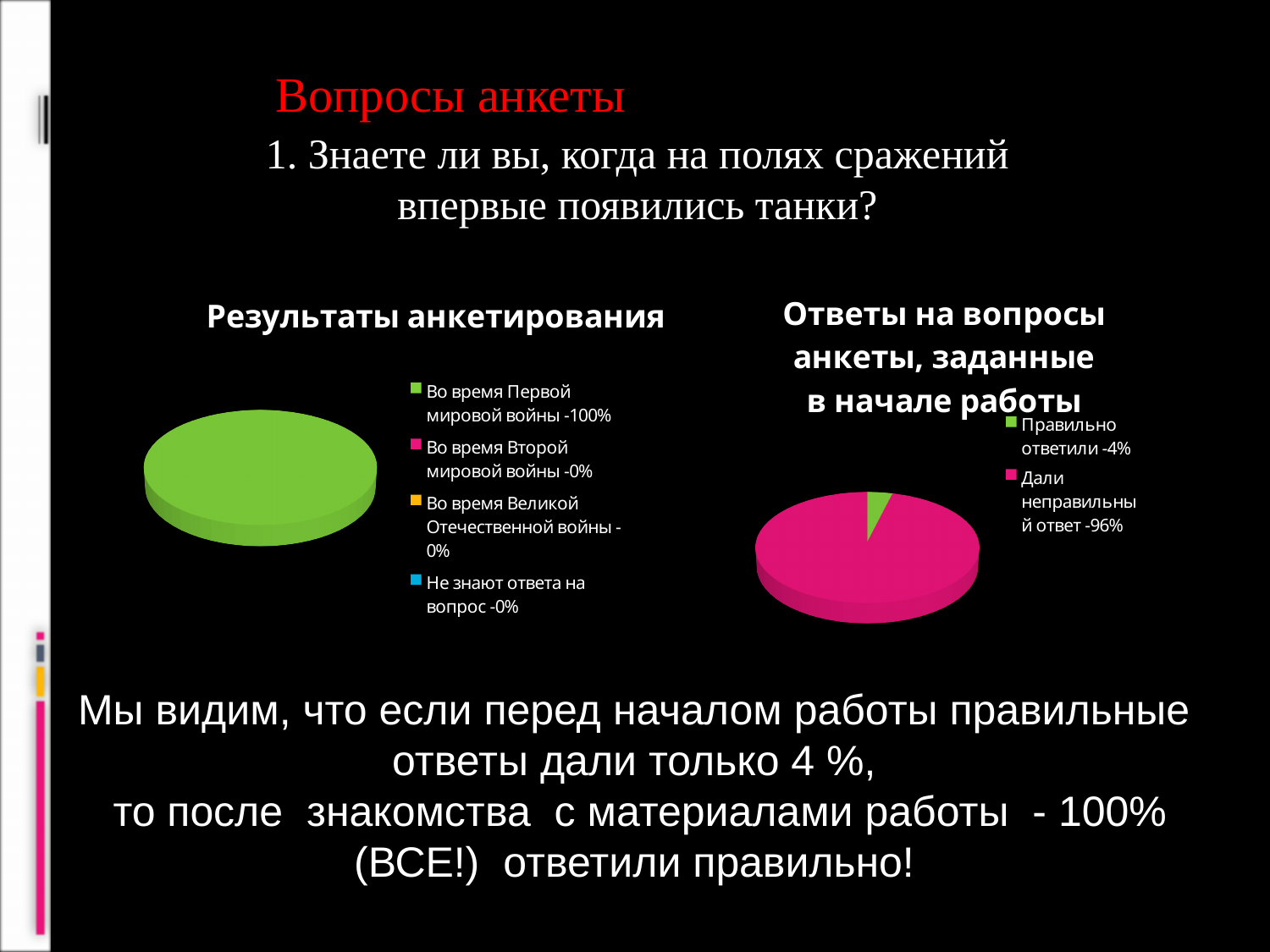
In the right chart "Ответы на вопросы анкеты, заданные в начале работы", which category has the smallest slice? Правильно ответили What type of chart is the right chart titled "Ответы на вопросы анкеты, заданные в начале работы"? pie chart How many entries does the legend of the left chart "Результаты анкетирования" list? 4 What type of chart is the left chart titled "Результаты анкетирования"? pie chart In the right chart "Ответы на вопросы анкеты, заданные в начале работы", what share is given for "Дали неправильный ответ"? 96% In the right chart "Ответы на вопросы анкеты, заданные в начале работы", what share is given for "Правильно ответили"? 4% In the left chart "Результаты анкетирования", what share is given for "Во время Второй мировой войны"? 0% In the right chart "Ответы на вопросы анкеты, заданные в начале работы", which category has the largest slice? Дали неправильный ответ In the right chart "Ответы на вопросы анкеты, заданные в начале работы", what colour is the slice for "Дали неправильный ответ"? pink In the left chart "Результаты анкетирования", what share is given for "Во время Первой мировой войны"? 100% How many entries does the legend of the right chart "Ответы на вопросы анкеты, заданные в начале работы" list? 2 In the right chart "Ответы на вопросы анкеты, заданные в начале работы", what is the difference between the shares for "Дали неправильный ответ" and "Правильно ответили"? 92%